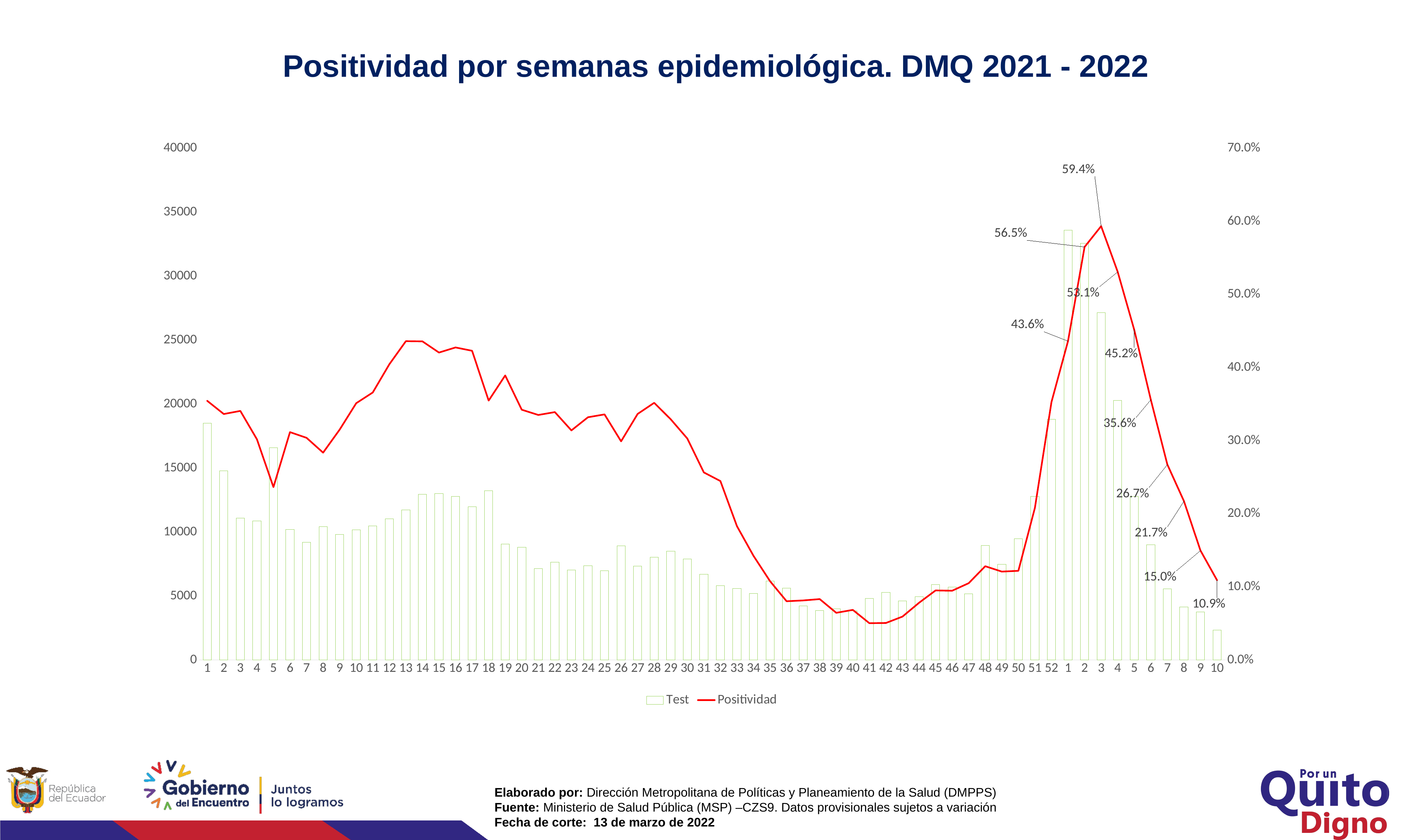
What is the Positividad value labelled for week 10 of 2022 (the last point on the x axis)? 10.9% Which is larger, the Positividad labelled for week 2 of 2022 (56.5%) or for week 4 of 2022 (53.1%)? Week 2 of 2022 (56.5%) What is the difference between the labelled Positividad values 59.4% and 53.1%? 6.3 percentage points How many series does the legend list? 2 What kind of chart is shown on the slide? A combination bar and line chart What is the Positividad value labelled for week 7 of 2022 (the second set of week numbers)? 26.7% What are the two series named in the legend? Test and Positividad What is the highest labelled Positividad value on the chart? 59.4% Does the Positividad line rise or fall from week 3 of 2022 to week 10 of 2022? It falls What is the Positividad value labelled for week 1 of 2022 (the first week of the second set of week numbers)? 43.6% Is the Test bar for week 1 of 2021 (the first bar) greater or less than 15000? greater